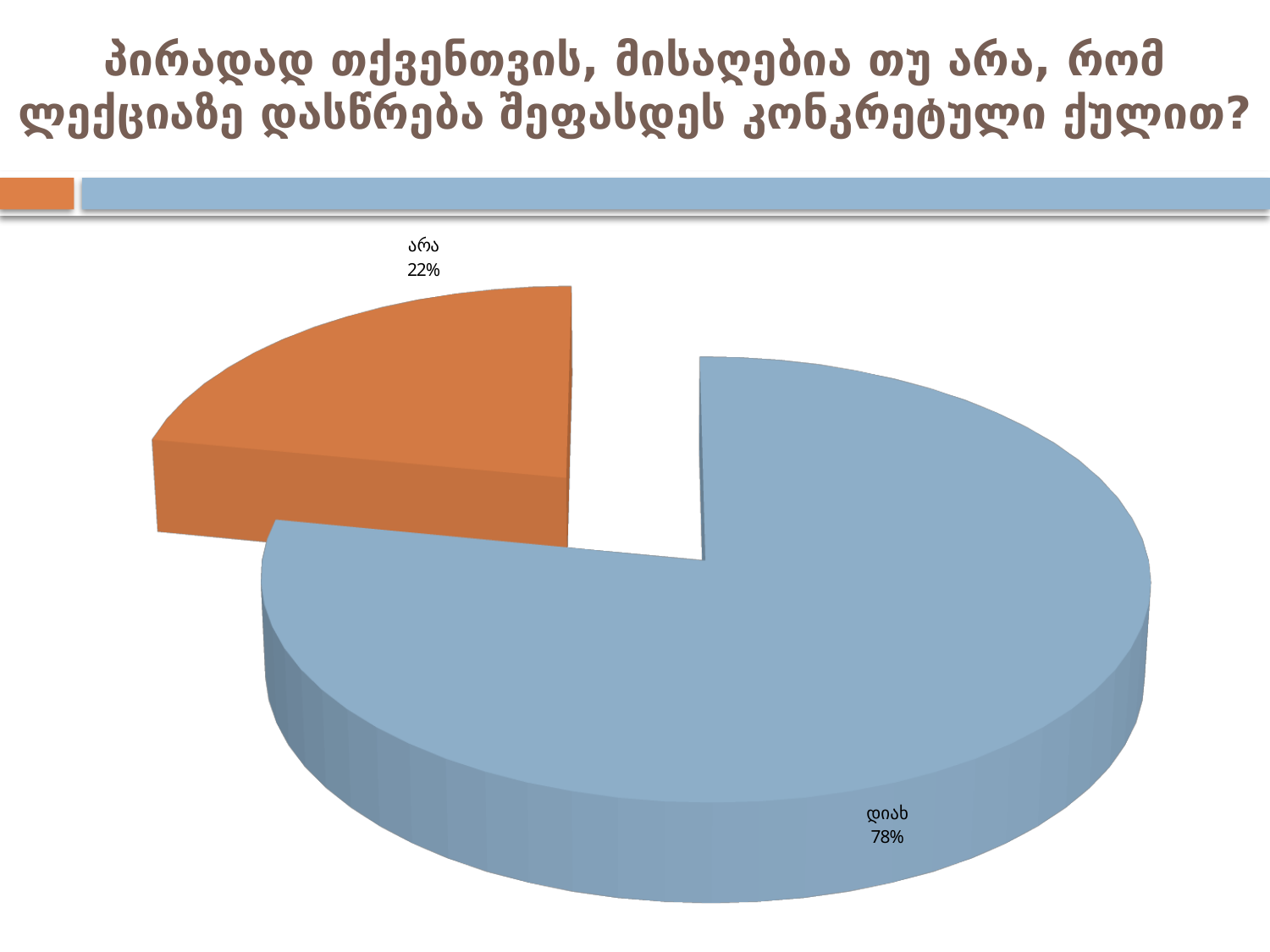
What colour is the "დიახ" slice? blue What kind of chart is shown on the slide? pie chart Which slice of the pie is the largest? დიახ What colour is the "არა" slice? orange What percentage is shown for the "არა" slice? 22% What is the difference in percentage points between the "დიახ" and "არა" slices? 56 Which is larger, the "არა" slice or the "დიახ" slice? დიახ What share of the pie does the "არა" slice represent? 22% How many slices does the pie chart have? 2 Which slice of the pie is the smallest? არა What percentage is shown for the "დიახ" slice? 78%